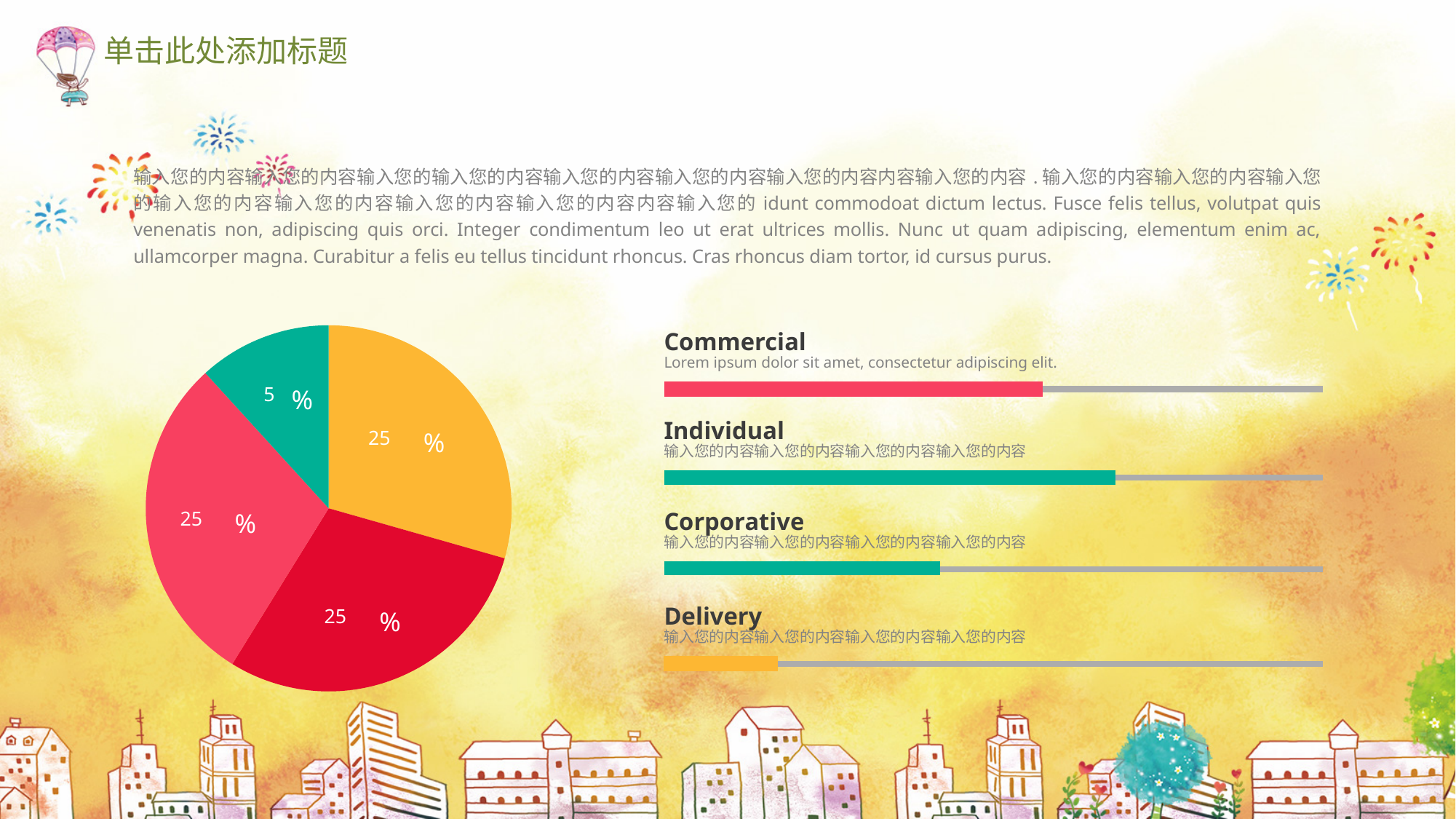
Is the value labelled on the teal slice larger or smaller than the value on the yellow slice? smaller What kind of chart is shown on the left of the slide? pie chart What are the four labels listed next to the progress bars to the right of the pie chart? Commercial, Individual, Corporative, Delivery Which colour slice of the pie chart is the smallest? teal (green) How many slices does the pie chart have? 4 How many slices of the pie chart are labelled 25 %? 3 What value is labelled on the teal (green) slice of the pie chart? 5 % What value is labelled on the pink slice on the left of the pie chart? 25 % What is the difference between the value labelled on the yellow slice and the value labelled on the teal slice? 20 % What value is labelled on the red slice at the bottom of the pie chart? 25 % Does the pie chart have a legend? No What value is labelled on the yellow slice of the pie chart? 25 %